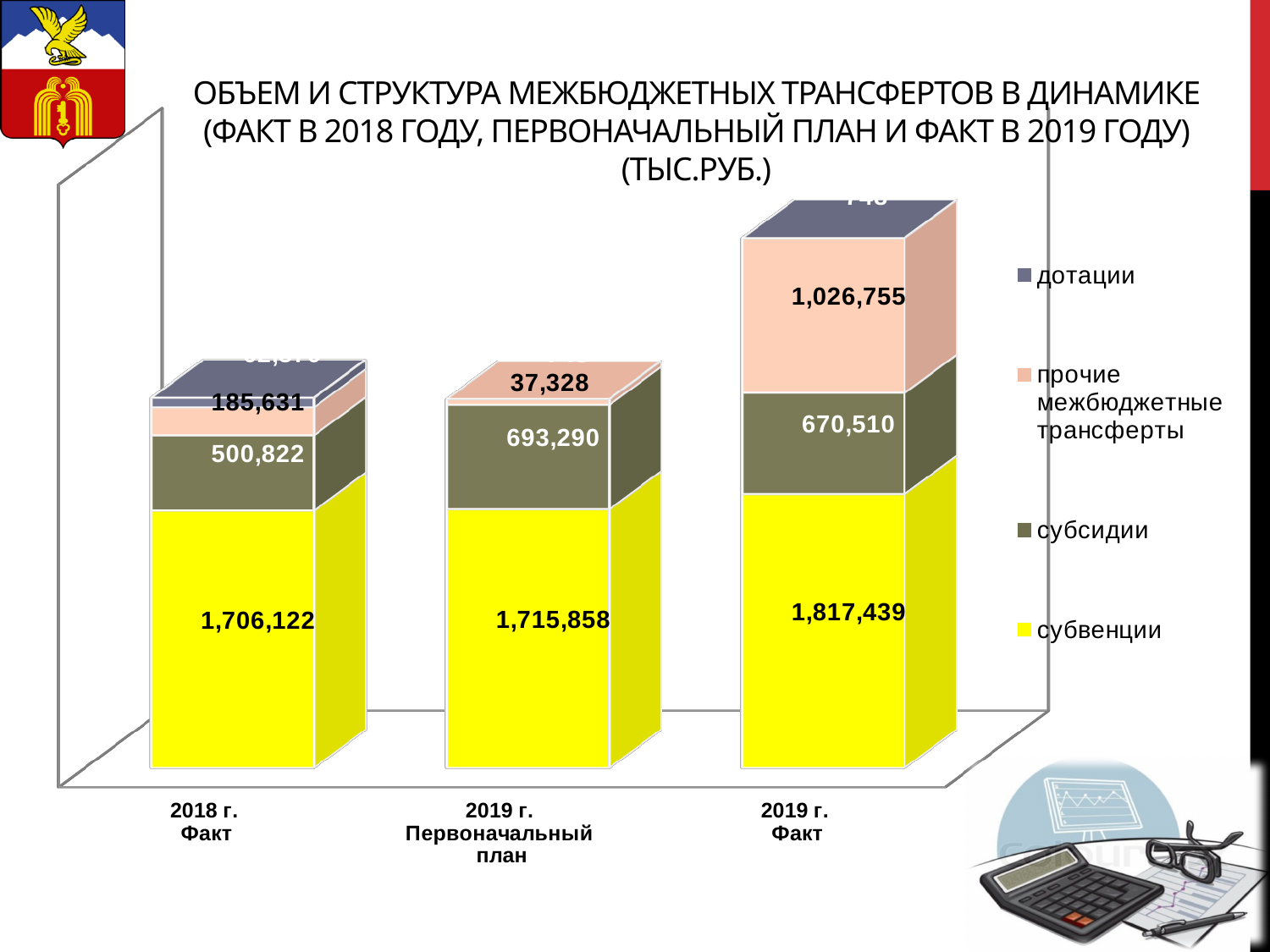
How many categories are shown on the x axis? 3 Which is larger for субсидии: 2019 г. Первоначальный план or 2019 г. Факт? 2019 г. Первоначальный план What is the difference between субсидии for 2019 г. Первоначальный план and 2018 г. Факт? 192,468 What kind of chart is shown on the slide? Stacked bar chart How many series does the legend list? 4 What is the difference between субвенции for 2019 г. Факт and 2018 г. Факт? 111,317 Do the values for субвенции rise or fall from 2018 г. Факт to 2019 г. Факт? Rise Which category has the highest value for субвенции? 2019 г. Факт What is the value of субсидии for 2019 г. Первоначальный план? 693,290 What is the value of прочие межбюджетные трансферты for 2019 г. Факт? 1,026,755 Which category has the lowest value for прочие межбюджетные трансферты? 2019 г. Первоначальный план What is the value of субвенции for 2018 г. Факт? 1,706,122